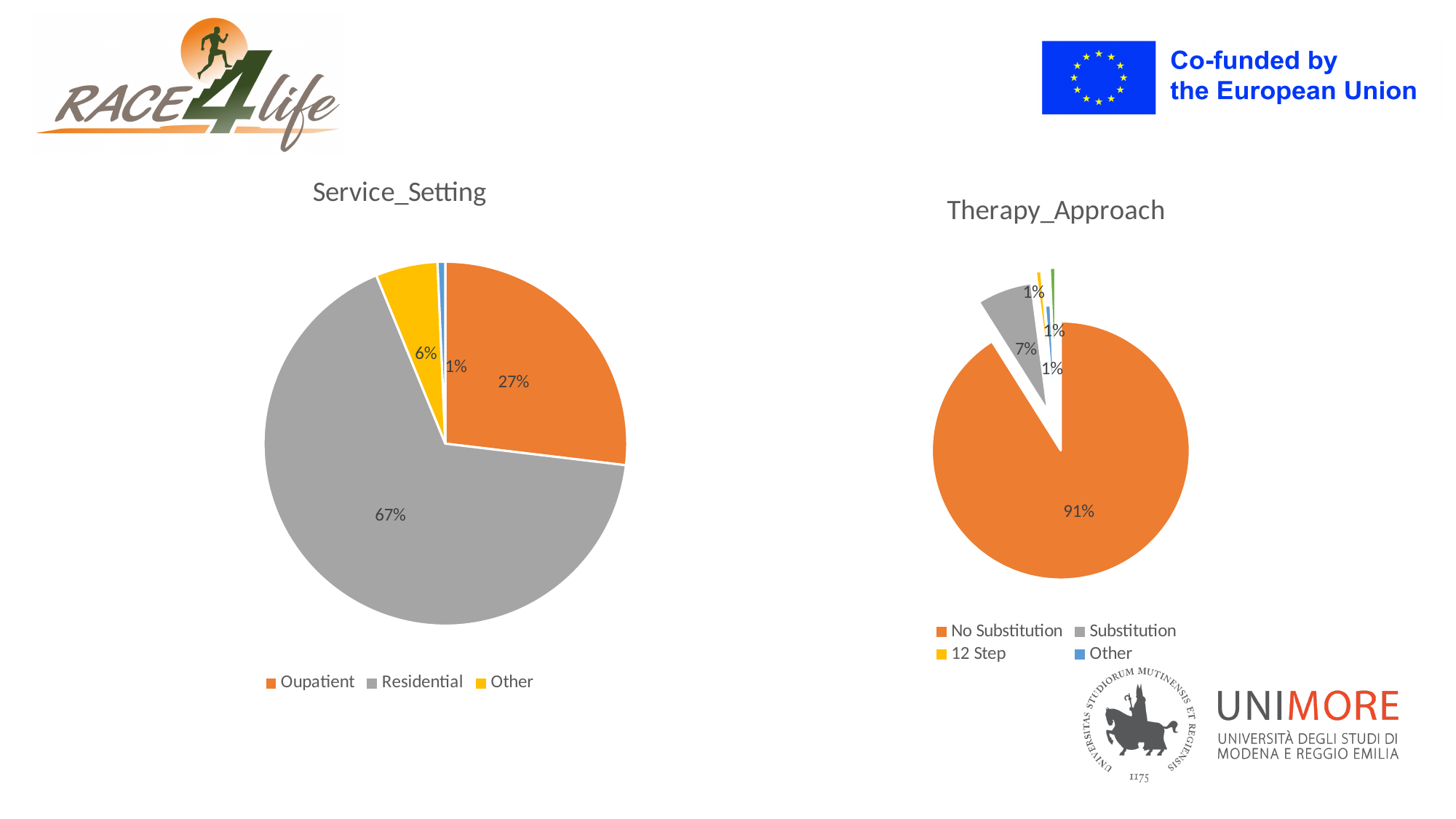
In the Therapy_Approach chart, what share is Substitution? 7% In the Service_Setting chart, what share is Residential? 67% In the Therapy_Approach chart, what is the difference between the No Substitution and Substitution shares? 84% In the Therapy_Approach chart, which category has the largest slice? No Substitution In the Service_Setting chart, which category has the largest slice? Residential In the Service_Setting chart, what share is Other? 6% How many entries does the legend of the Therapy_Approach chart list? 4 In the Therapy_Approach chart, what share is No Substitution? 91% In the Service_Setting chart, what is the difference between the Residential and Oupatient shares? 40% What type of chart is the Service_Setting chart? Pie chart In the Service_Setting chart, which is larger, Oupatient or Other? Oupatient In the Service_Setting chart, what share is Oupatient? 27%